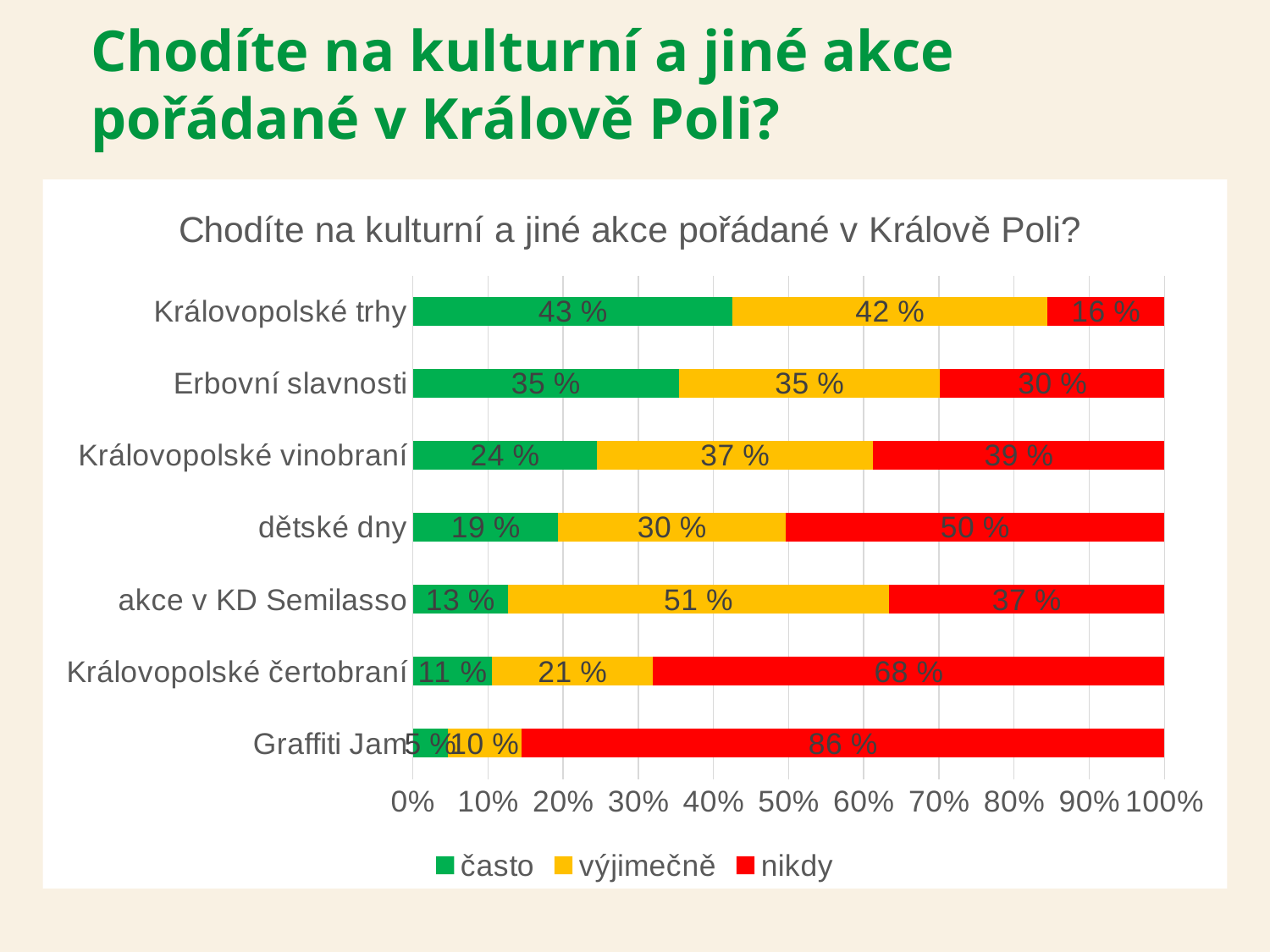
How many categories are shown on the chart? 7 Which category has the lowest 'nikdy' value? Královopolské trhy What is the 'výjimečně' value for akce v KD Semilasso? 51 % Which colour represents the 'nikdy' series? Red What is the total of the stacked bar for Erbovní slavnosti? 100 % How many series does the legend list? 3 What is the 'často' value for Královopolské trhy? 43 % What is the 'nikdy' value for Graffiti Jam? 86 % What kind of chart is shown on the slide? Stacked bar chart Which is larger: the 'výjimečně' value for Erbovní slavnosti or for Královopolské vinobraní? Královopolské vinobraní What is the difference between the 'nikdy' values for Královopolské čertobraní and dětské dny? 18 % Which category has the highest 'často' value? Královopolské trhy